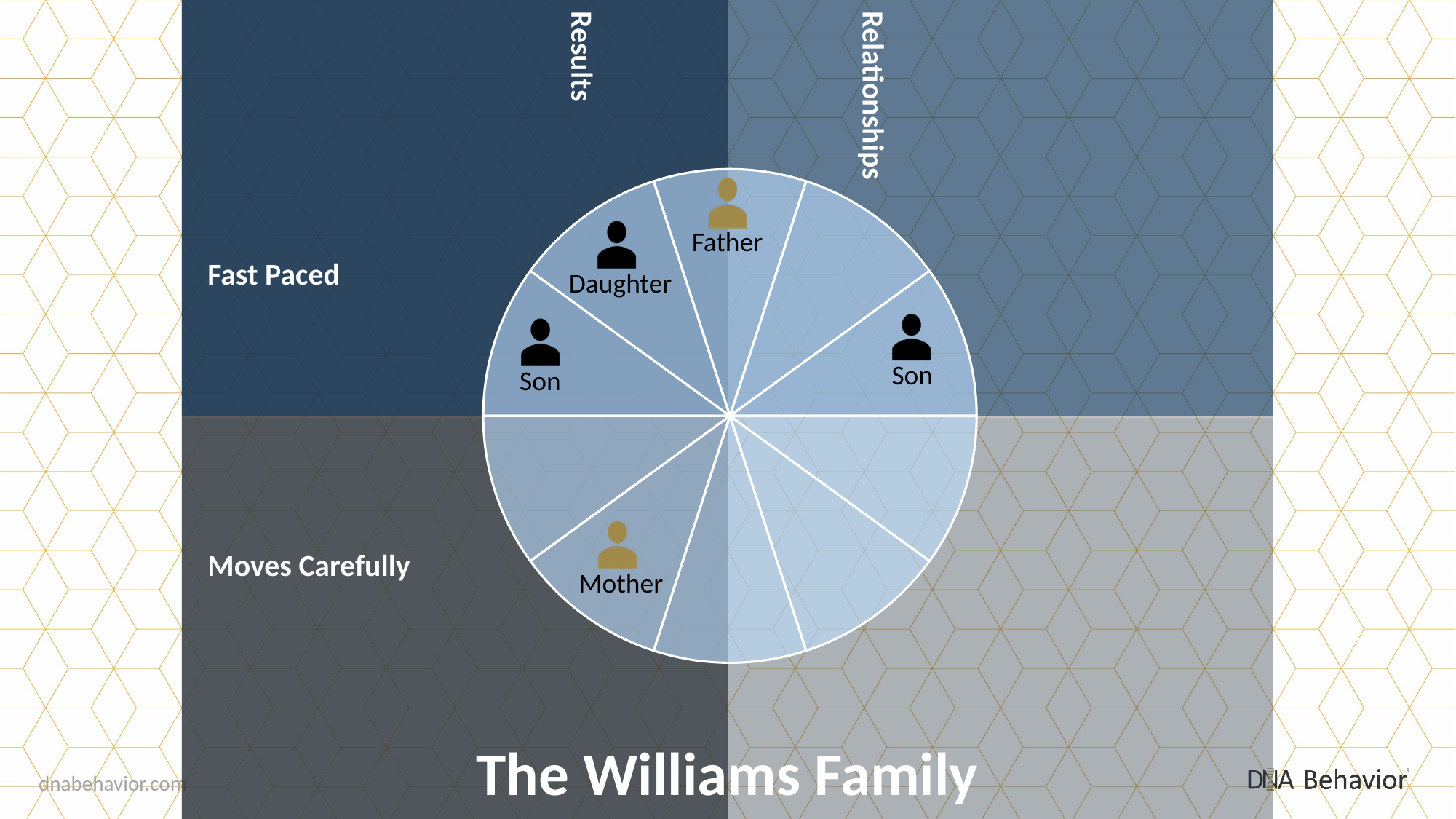
What kind of chart is shown on the slide? Pie chart What is the title of the chart? The Williams Family Which family member is placed in the Relationships / Fast Paced quadrant of the chart? Son How many slices is the circular chart divided into? 10 What are the two labels on the left side of the slide describing the top and bottom halves of the chart? Fast Paced and Moves Carefully How many family members on the chart are labelled "Son"? 2 Which family member is placed in the Moves Carefully half of the chart? Mother How many family members are labelled on the chart? 5 Are the slices of the chart equal in size? Yes